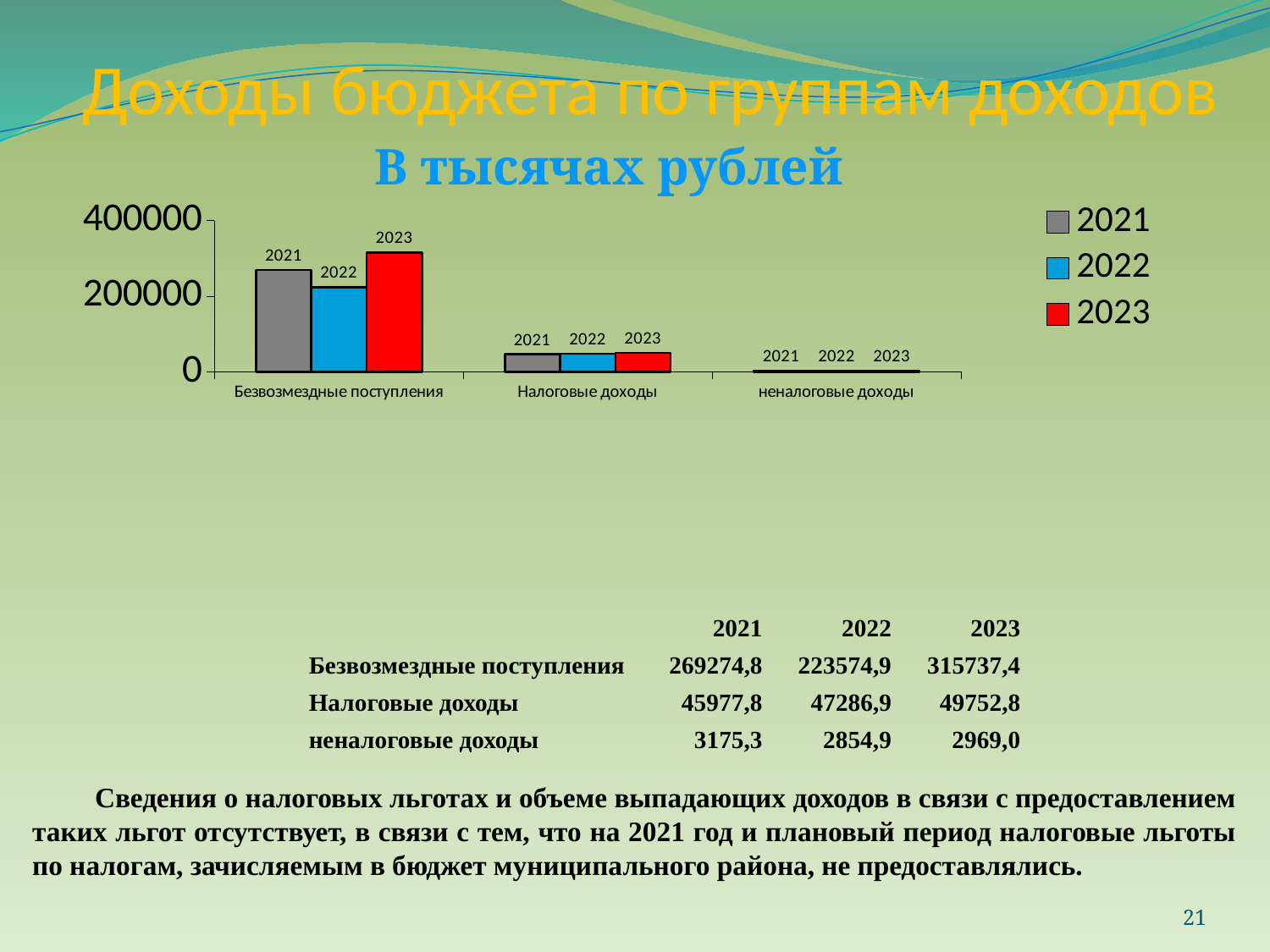
How many categories are shown on the x axis of the chart? 3 How many series does the chart legend list? 3 Which category has the lowest bars in the chart? неналоговые доходы Which category has the highest bars in the chart? Безвозмездные поступления What is the value for Налоговые доходы in 2021, as printed on the slide? 45977,8 Is the 2022 value for Налоговые доходы greater or less than 200000? less Which legend entry is shown in red? 2023 What is the value for Безвозмездные поступления in 2023, as printed on the slide? 315737,4 Which is larger for Безвозмездные поступления: the 2021 bar or the 2022 bar? 2021 What kind of chart is shown on the slide? bar chart What unit is stated in the chart's subtitle? В тысячах рублей Is the 2023 value for Безвозмездные поступления greater or less than 200000? greater